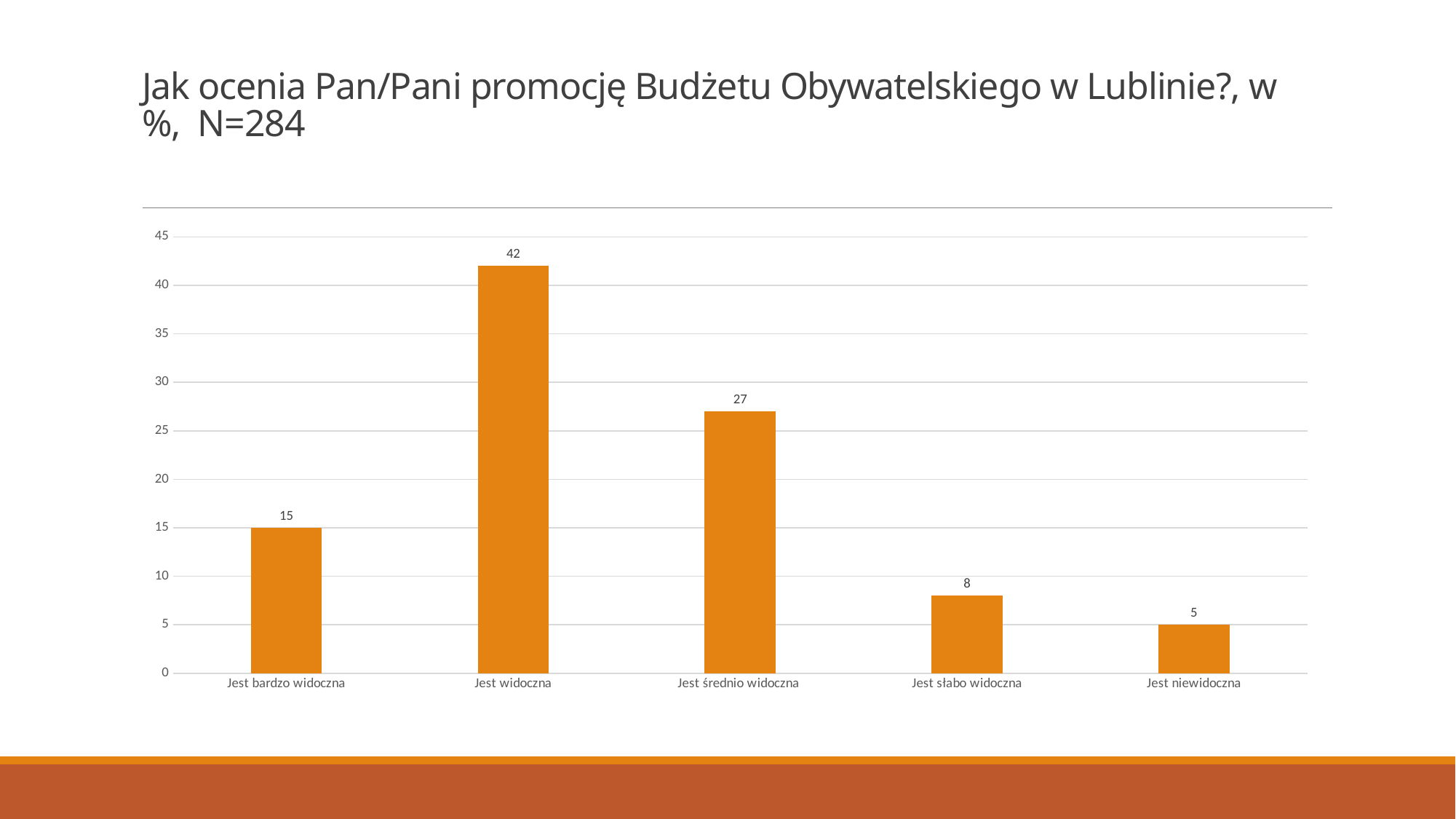
What is the sample size (N) stated in the slide title? 284 What is the value for "Jest widoczna"? 42 Which is larger, the value for "Jest bardzo widoczna" or the value for "Jest słabo widoczna"? Jest bardzo widoczna Which category has the highest value? Jest widoczna How many categories are shown on the x axis? 5 What is the value for "Jest niewidoczna"? 5 Which category has the lowest value? Jest niewidoczna Is the value for "Jest średnio widoczna" greater or less than 25? greater What is the value for "Jest słabo widoczna"? 8 What is the value for "Jest bardzo widoczna"? 15 What kind of chart is shown on the slide? bar chart What is the difference between the values for "Jest widoczna" and "Jest średnio widoczna"? 15